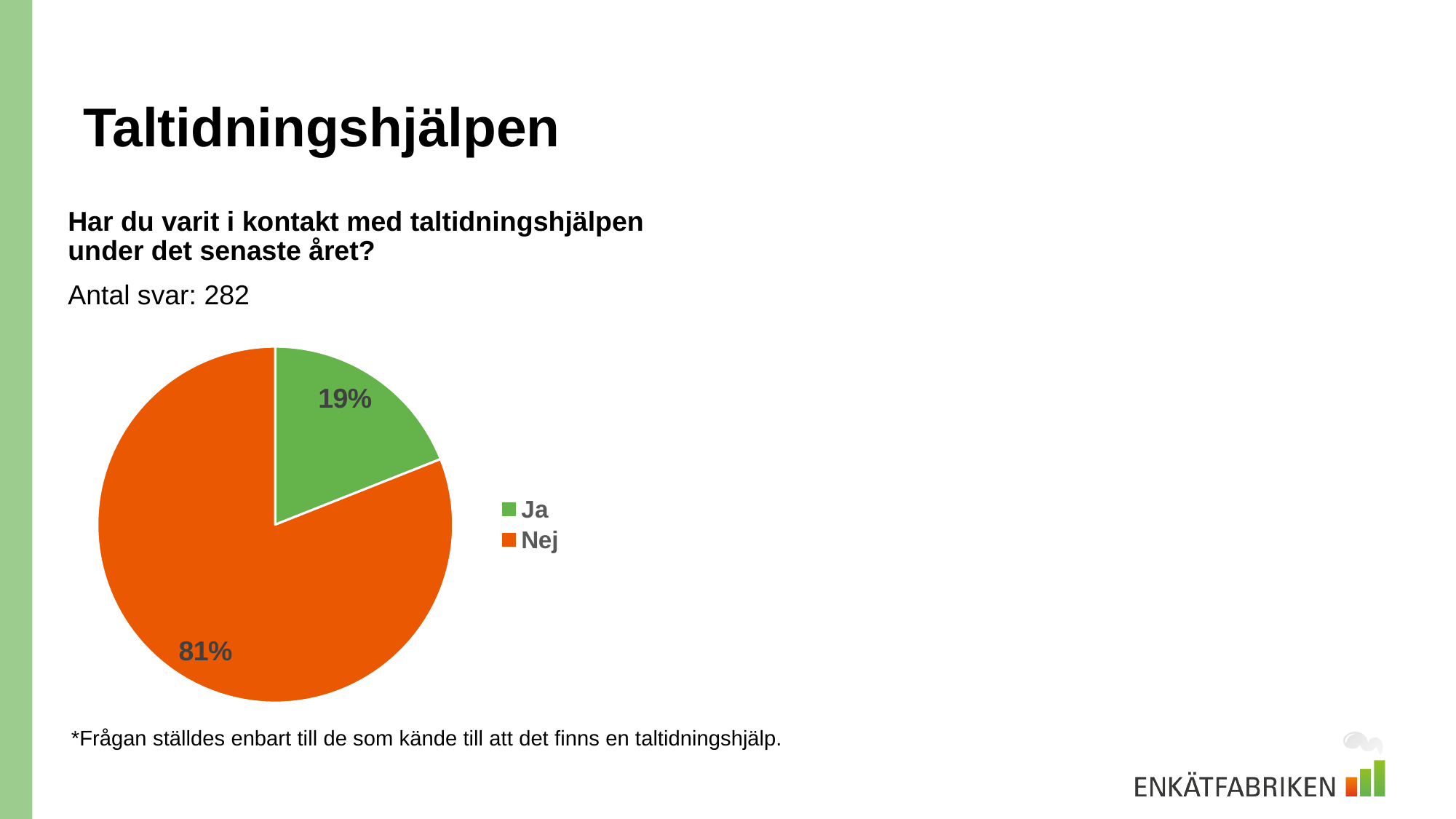
How many responses (Antal svar) does the slide report for this question? 282 Which response has the smallest share of the pie? Ja What is the difference in percentage points between the "Nej" and "Ja" slices? 62 What share of the pie does the "Ja" slice represent? 19% How many entries does the legend list? 2 What percentage of respondents answered "Nej"? 81% How many slices does the pie chart have? 2 What colour is the "Nej" slice? Orange What kind of chart is shown on the slide? Pie chart Which slice is larger, "Ja" or "Nej"? Nej Which response has the largest share of the pie? Nej What percentage of respondents answered "Ja"? 19%